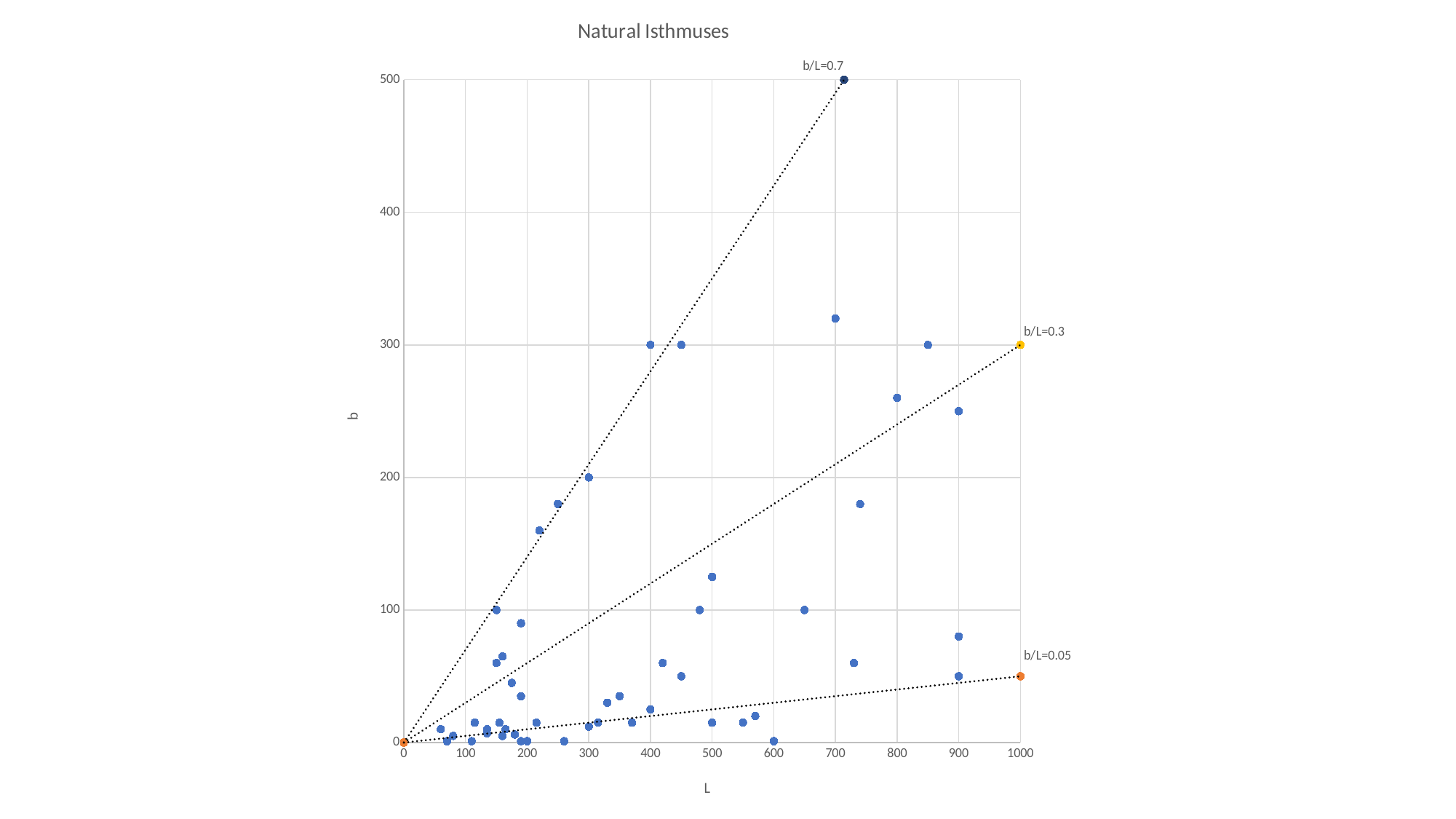
What kind of chart is shown on the slide? scatter chart Are there more blue data points below the b/L=0.3 line or above it? below Which dotted reference line is the flattest? b/L=0.05 What is the largest value shown on the x axis (L)? 1000 What is the title of the chart? Natural Isthmuses What are the titles of the x axis and the y axis of the chart? L and b At what value of b does the b/L=0.3 reference line end at L=1000? 300 Which dotted reference line is the steepest? b/L=0.7 Is the b value of the blue point at L=300 that lies near the b/L=0.7 line greater or less than 100? greater Is the highest blue data point's b value greater or less than 400? less How many dotted reference lines are drawn on the chart? 3 Is the highest blue data point's b value greater or less than 300? greater